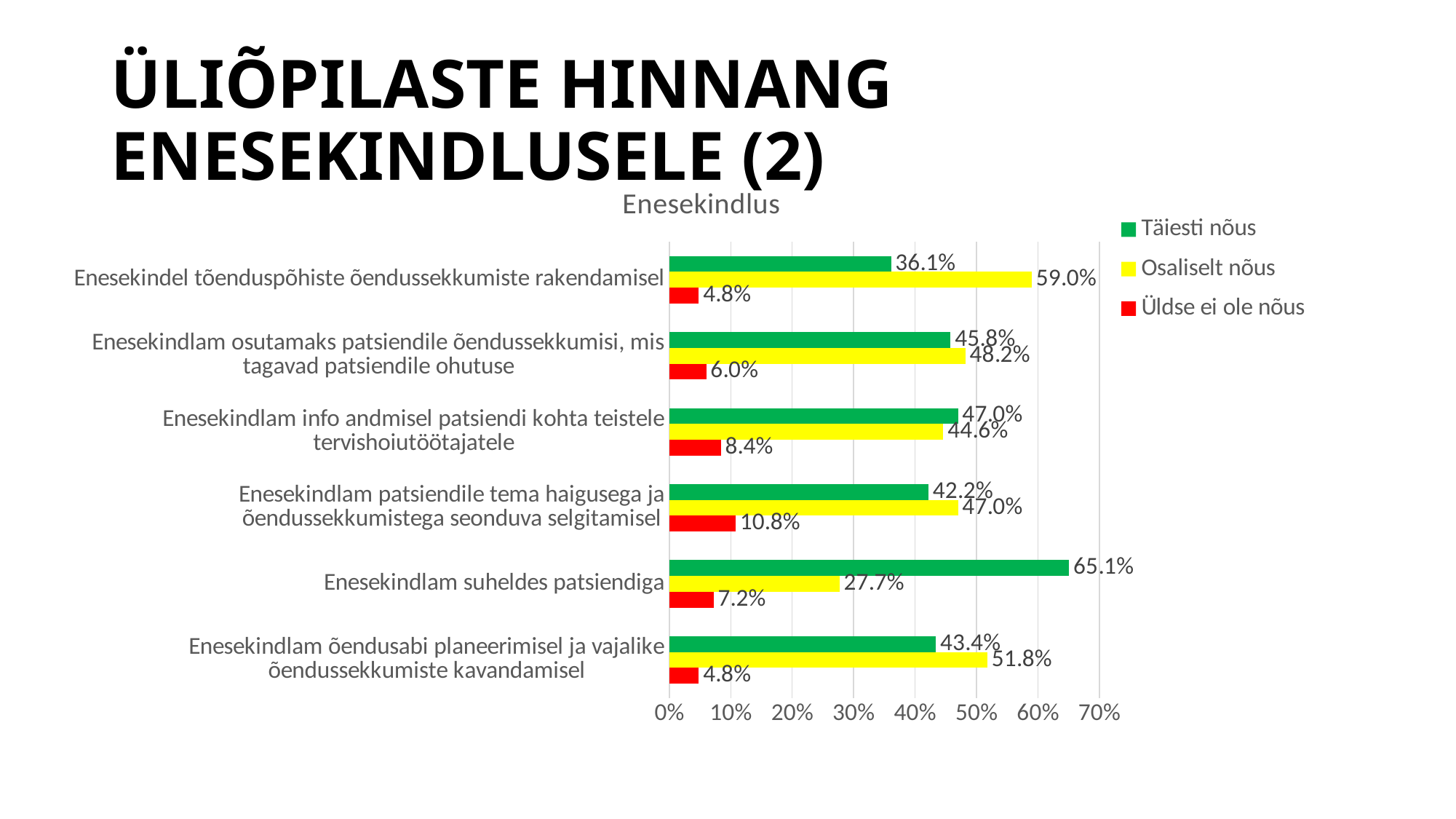
What is the 'Osaliselt nõus' value for 'Enesekindel tõenduspõhiste õendussekkumiste rakendamisel'? 59.0% For 'Enesekindlam info andmisel patsiendi kohta teistele tervishoiutöötajatele', which is larger: 'Täiesti nõus' or 'Osaliselt nõus'? Täiesti nõus Which category has the lowest 'Osaliselt nõus' value? Enesekindlam suheldes patsiendiga What is the title of the chart? Enesekindlus What is the difference between the 'Täiesti nõus' and 'Osaliselt nõus' values for 'Enesekindlam suheldes patsiendiga'? 37.4% Which category has the highest 'Üldse ei ole nõus' value? Enesekindlam patsiendile tema haigusega ja õendussekkumistega seonduva selgitamisel What type of chart is shown on the slide? Bar chart Which category has the highest 'Täiesti nõus' value? Enesekindlam suheldes patsiendiga What is the 'Täiesti nõus' value for 'Enesekindlam suheldes patsiendiga'? 65.1% How many series does the legend list? 3 What is the 'Üldse ei ole nõus' value for 'Enesekindlam patsiendile tema haigusega ja õendussekkumistega seonduva selgitamisel'? 10.8% How many categories are shown in the chart? 6